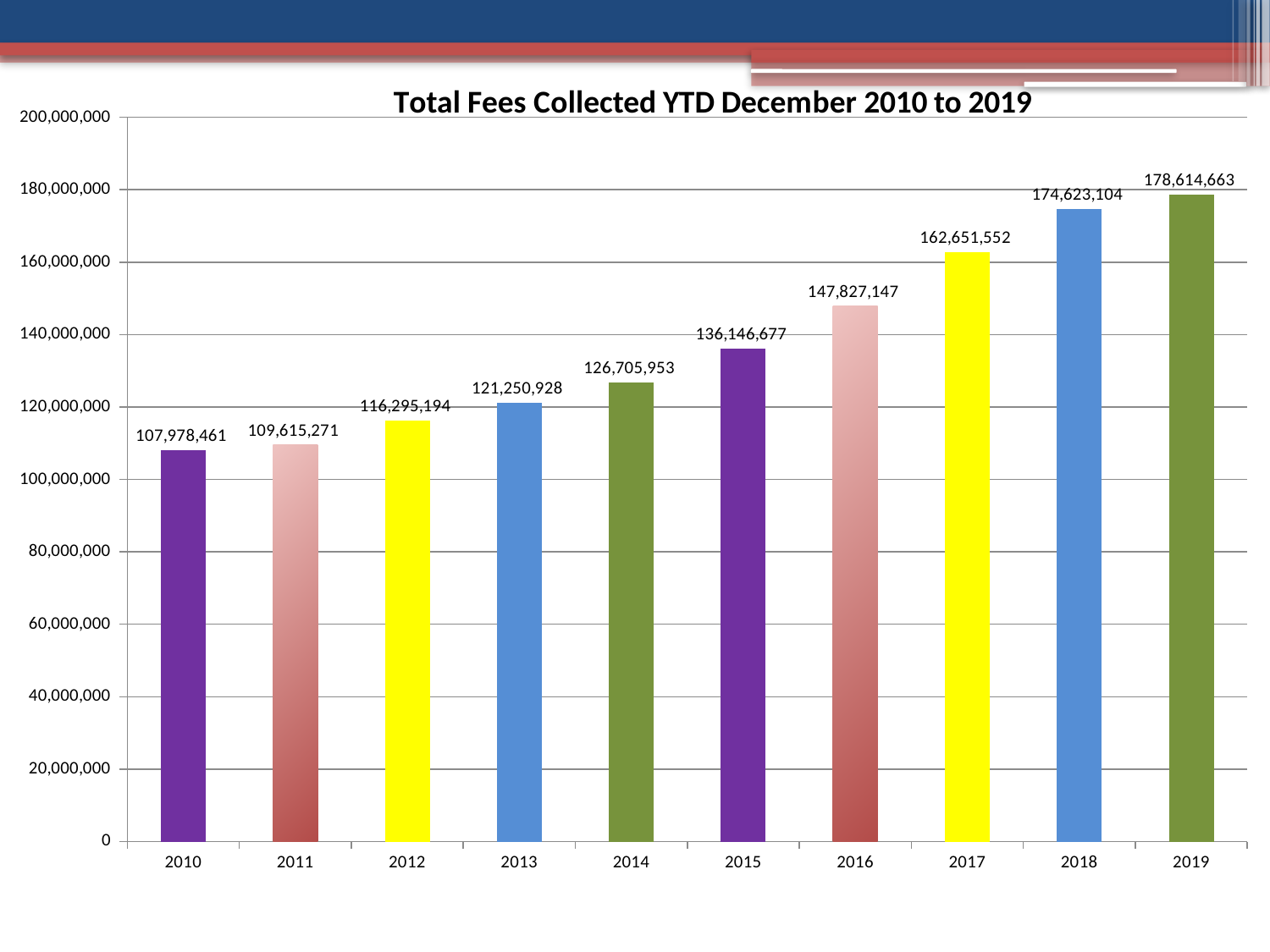
Which year has the lowest total fees collected? 2010 How many years are shown on the x axis? 10 Which is larger, the value for 2014 or the value for 2015? 2015 Which year has the highest total fees collected? 2019 What is the value for 2010? 107,978,461 What kind of chart is this? bar chart What is the value for 2019? 178,614,663 What is the difference between the values for 2019 and 2010? 70,636,202 What is the value for 2016? 147,827,147 Is the value for 2017 greater or less than 160,000,000? greater What is the difference between the values for 2018 and 2017? 11,971,552 Do the values rise or fall from 2010 to 2019? rise